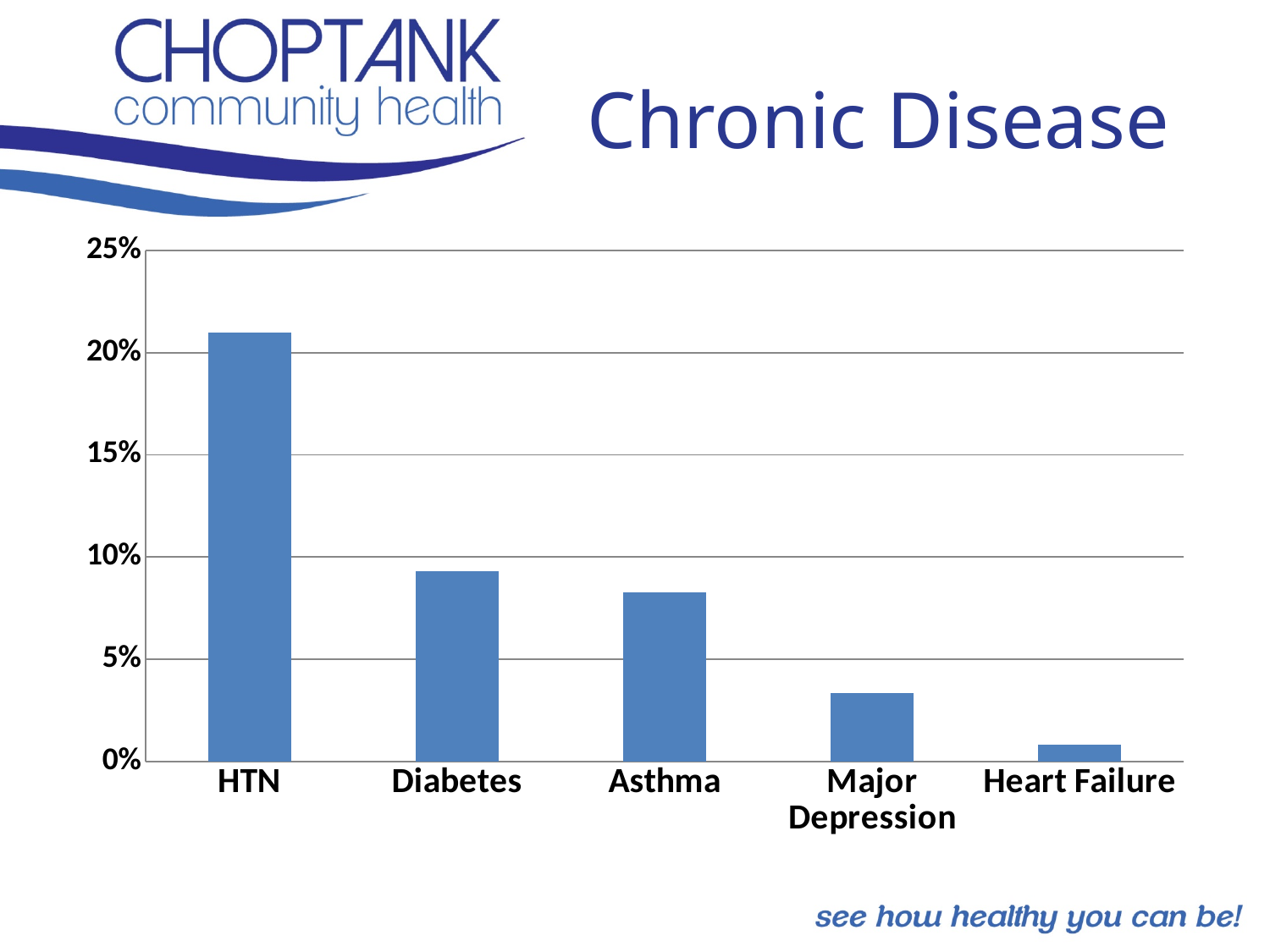
Which has a larger value, Major Depression or Heart Failure? Major Depression How many chronic disease categories are shown in the chart? 5 What kind of chart is shown on the slide? bar chart Is the value for Diabetes greater or less than 10%? less Which has a larger value, HTN or Diabetes? HTN Is the value for Asthma greater or less than 5%? greater Which chronic disease has the highest value in the chart? HTN Do the values rise or fall moving from left to right across the categories? fall Is the value for Major Depression greater or less than 5%? less Which chronic disease has the lowest value in the chart? Heart Failure